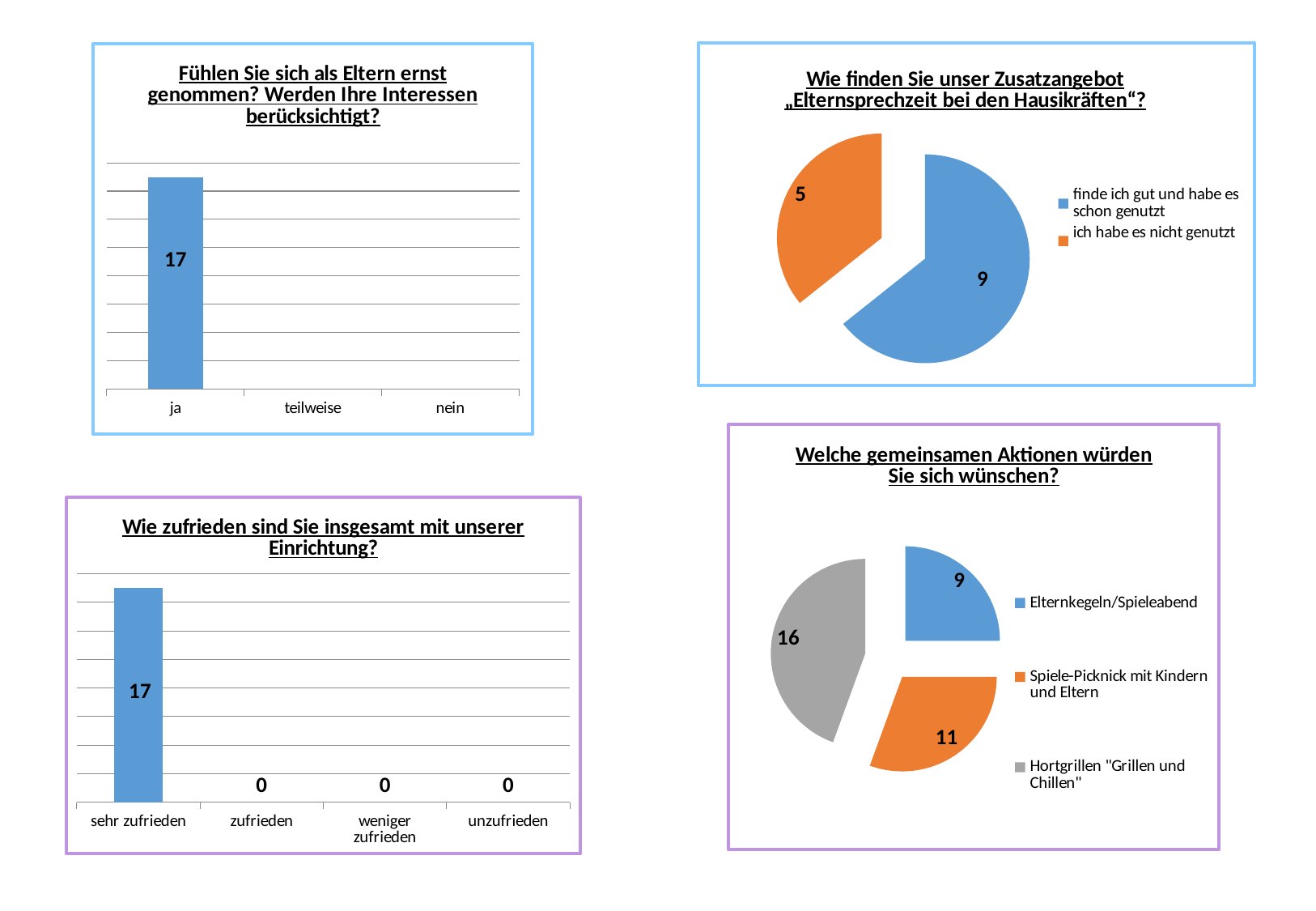
In the chart "Fühlen Sie sich als Eltern ernst genommen? Werden Ihre Interessen berücksichtigt?", what is the value for "ja"? 17 In the pie chart "Welche gemeinsamen Aktionen würden Sie sich wünschen?", which is larger: "Hortgrillen "Grillen und Chillen"" or "Spiele-Picknick mit Kindern und Eltern"? Hortgrillen "Grillen und Chillen" In the pie chart "Wie finden Sie unser Zusatzangebot „Elternsprechzeit bei den Hausikräften“?", what is the value for "ich habe es nicht genutzt"? 5 In the chart "Wie zufrieden sind Sie insgesamt mit unserer Einrichtung?", what is the value for "unzufrieden"? 0 In the pie chart "Wie finden Sie unser Zusatzangebot „Elternsprechzeit bei den Hausikräften“?", what is the difference between "finde ich gut und habe es schon genutzt" and "ich habe es nicht genutzt"? 4 In the pie chart "Welche gemeinsamen Aktionen würden Sie sich wünschen?", which option has the smallest value? Elternkegeln/Spieleabend In the chart "Fühlen Sie sich als Eltern ernst genommen? Werden Ihre Interessen berücksichtigt?", how many categories are shown on the x axis? 3 In the chart "Wie zufrieden sind Sie insgesamt mit unserer Einrichtung?", how many categories are shown on the x axis? 4 In the pie chart "Wie finden Sie unser Zusatzangebot „Elternsprechzeit bei den Hausikräften“?", which slice is the largest? finde ich gut und habe es schon genutzt In the chart "Wie zufrieden sind Sie insgesamt mit unserer Einrichtung?", what is the value for "sehr zufrieden"? 17 What kind of chart is "Fühlen Sie sich als Eltern ernst genommen? Werden Ihre Interessen berücksichtigt?"? bar chart In the pie chart "Welche gemeinsamen Aktionen würden Sie sich wünschen?", what is the value for "Spiele-Picknick mit Kindern und Eltern"? 11